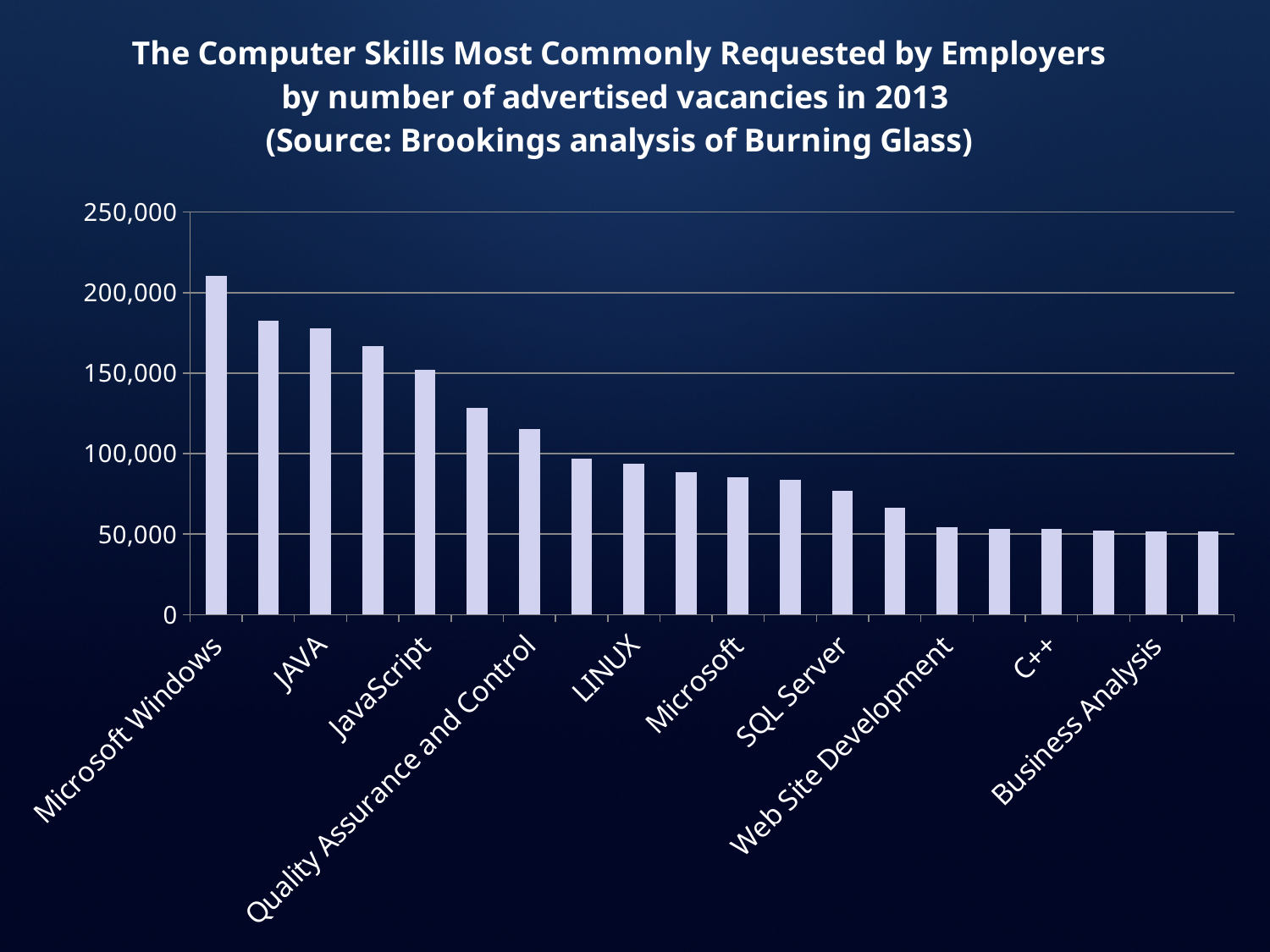
Is the value for JavaScript greater or less than 200,000? less Do the values rise or fall moving from left to right along the x axis? fall Is the value for Microsoft Windows greater or less than 200,000? greater Is the value for SQL Server greater or less than 50,000? greater Which has more advertised vacancies, JAVA or JavaScript? JAVA What kind of chart is shown on the slide? bar chart Which computer skill has the highest number of advertised vacancies? Microsoft Windows Which has more advertised vacancies, LINUX or SQL Server? LINUX